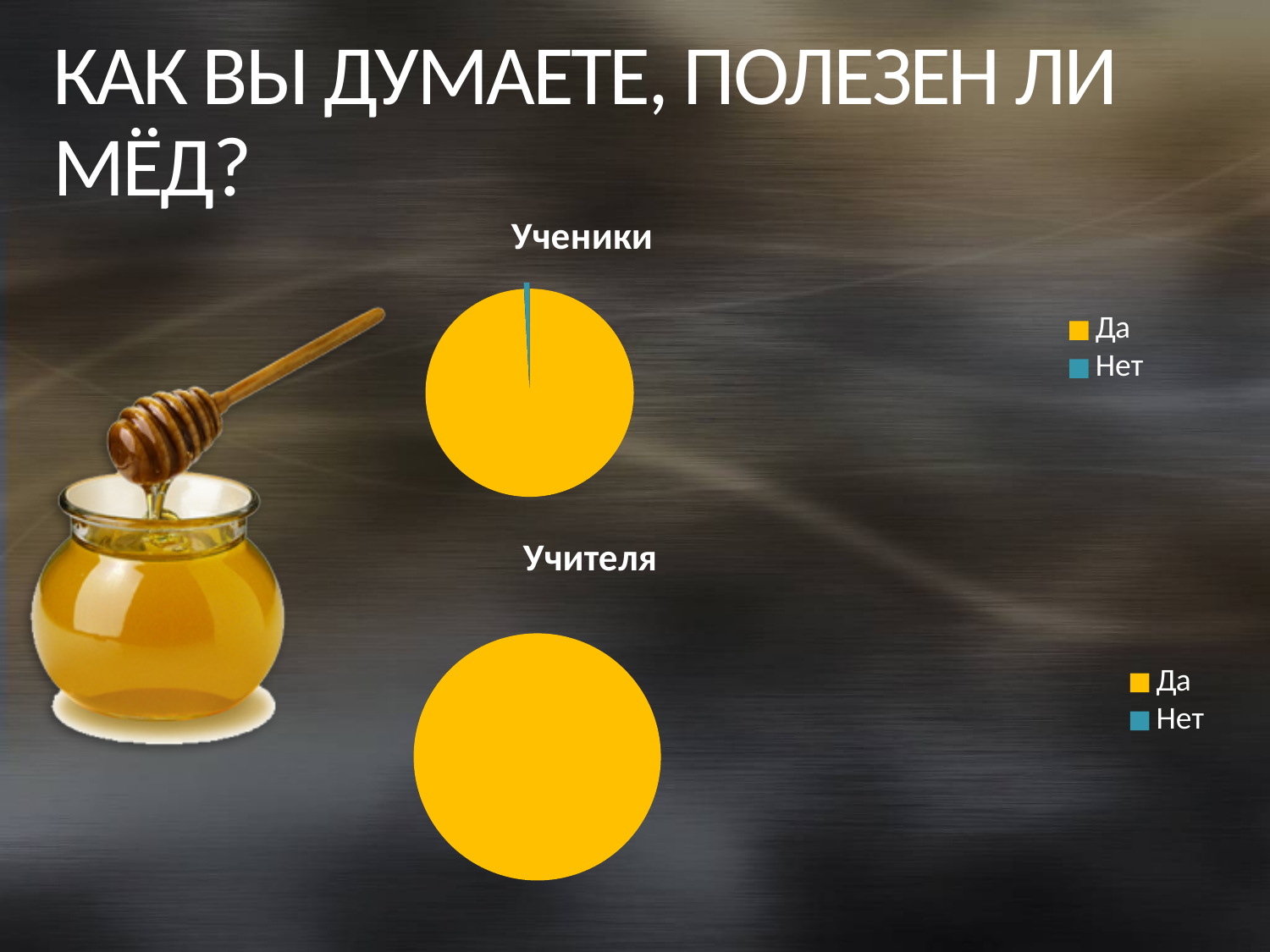
In the "Ученики" chart, which category has the largest slice? Да In the "Учителя" chart, what colour represents Да? yellow In the "Ученики" chart, which is larger, the slice for Да or the slice for Нет? Да What is the title of the upper pie chart? Ученики What kind of chart is the "Учителя" chart? pie chart How many entries does the legend of the "Учителя" chart list? 2 In the "Учителя" chart, which is larger, the slice for Да or the slice for Нет? Да In the "Учителя" chart, which category has the largest slice? Да In the "Ученики" chart, which category has the smallest slice? Нет How many entries does the legend of the "Ученики" chart list? 2 What kind of chart is the "Ученики" chart? pie chart